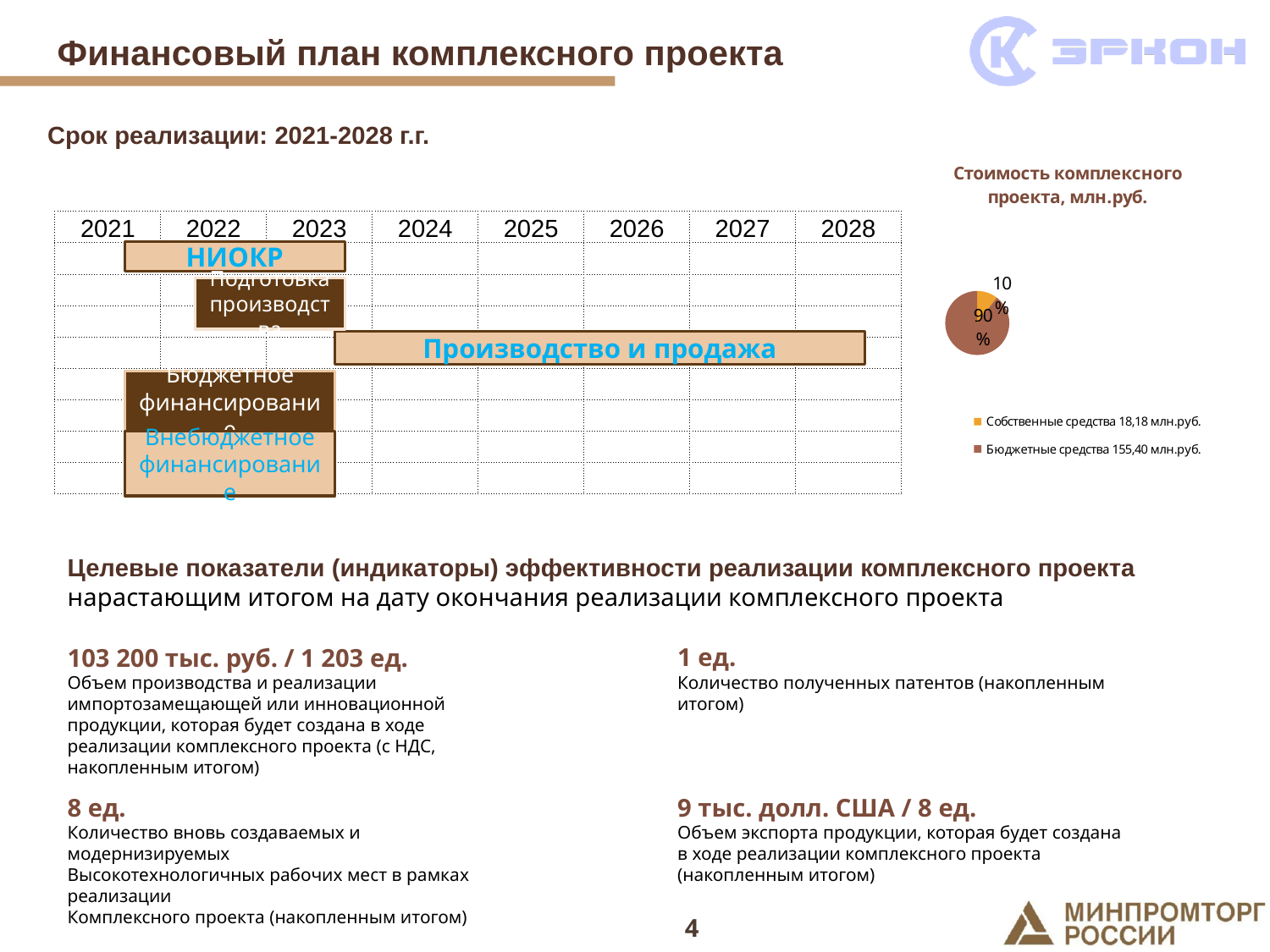
According to the legend of the pie chart "Стоимость комплексного проекта, млн.руб.", what is the amount of Бюджетные средства? 155,40 млн.руб. How many slices does the pie chart "Стоимость комплексного проекта, млн.руб." have? 2 In the pie chart "Стоимость комплексного проекта, млн.руб.", what is the difference between Бюджетные средства and Собственные средства in млн.руб.? 137,22 млн.руб. In the pie chart "Стоимость комплексного проекта, млн.руб.", which slice is the largest? Бюджетные средства What kind of chart is shown under the title "Стоимость комплексного проекта, млн.руб."? pie chart According to the legend of the pie chart "Стоимость комплексного проекта, млн.руб.", what is the amount of Собственные средства? 18,18 млн.руб. In the pie chart "Стоимость комплексного проекта, млн.руб.", which is larger: Собственные средства or Бюджетные средства? Бюджетные средства What is the title of the pie chart on the right side of the slide? Стоимость комплексного проекта, млн.руб. In the pie chart "Стоимость комплексного проекта, млн.руб.", which slice is the smallest? Собственные средства How many entries does the legend of the pie chart "Стоимость комплексного проекта, млн.руб." list? 2 In the pie chart "Стоимость комплексного проекта, млн.руб.", what share is labelled for Бюджетные средства? 90% In the pie chart "Стоимость комплексного проекта, млн.руб.", what share is labelled for Собственные средства? 10%